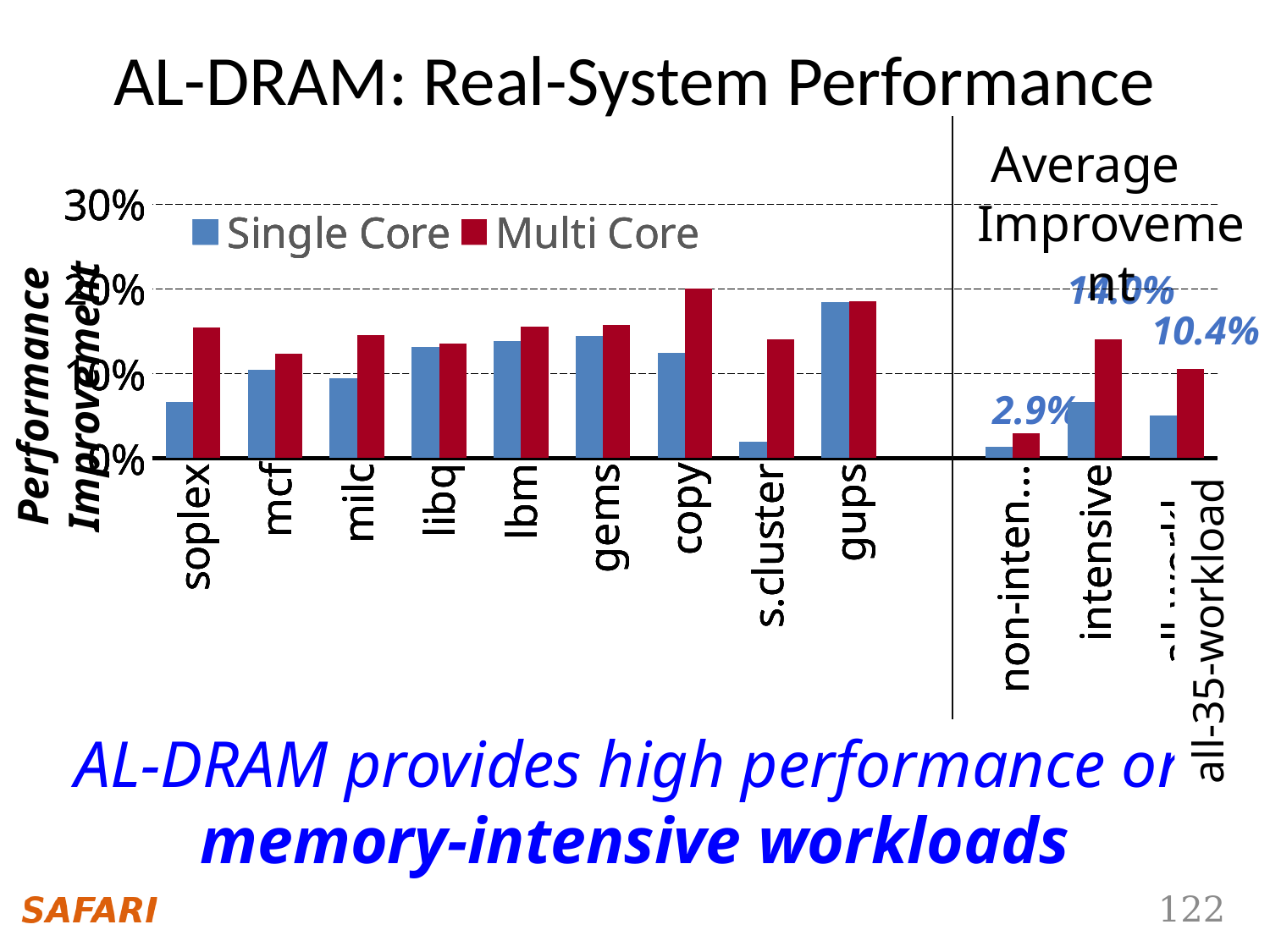
What are the two series named in the chart's legend? Single Core and Multi Core Which benchmark has the highest Multi Core performance improvement? copy For copy, which is larger: the Single Core or the Multi Core performance improvement? Multi Core For soplex, which is larger: the Single Core or the Multi Core performance improvement? Multi Core What is the Multi Core performance improvement labelled for the non-intensive workloads? 2.9% What is the title of the slide containing the chart? AL-DRAM: Real-System Performance Among the nine individual benchmarks (soplex through gups), which has the lowest Single Core performance improvement? s.cluster Is the Single Core value for gups greater or less than 10%? greater Is the Single Core value for s.cluster greater or less than 10%? less How many series does the chart's legend list? 2 What is the Multi Core performance improvement labelled for all-35-workload? 10.4% What kind of chart is shown on the slide? bar chart